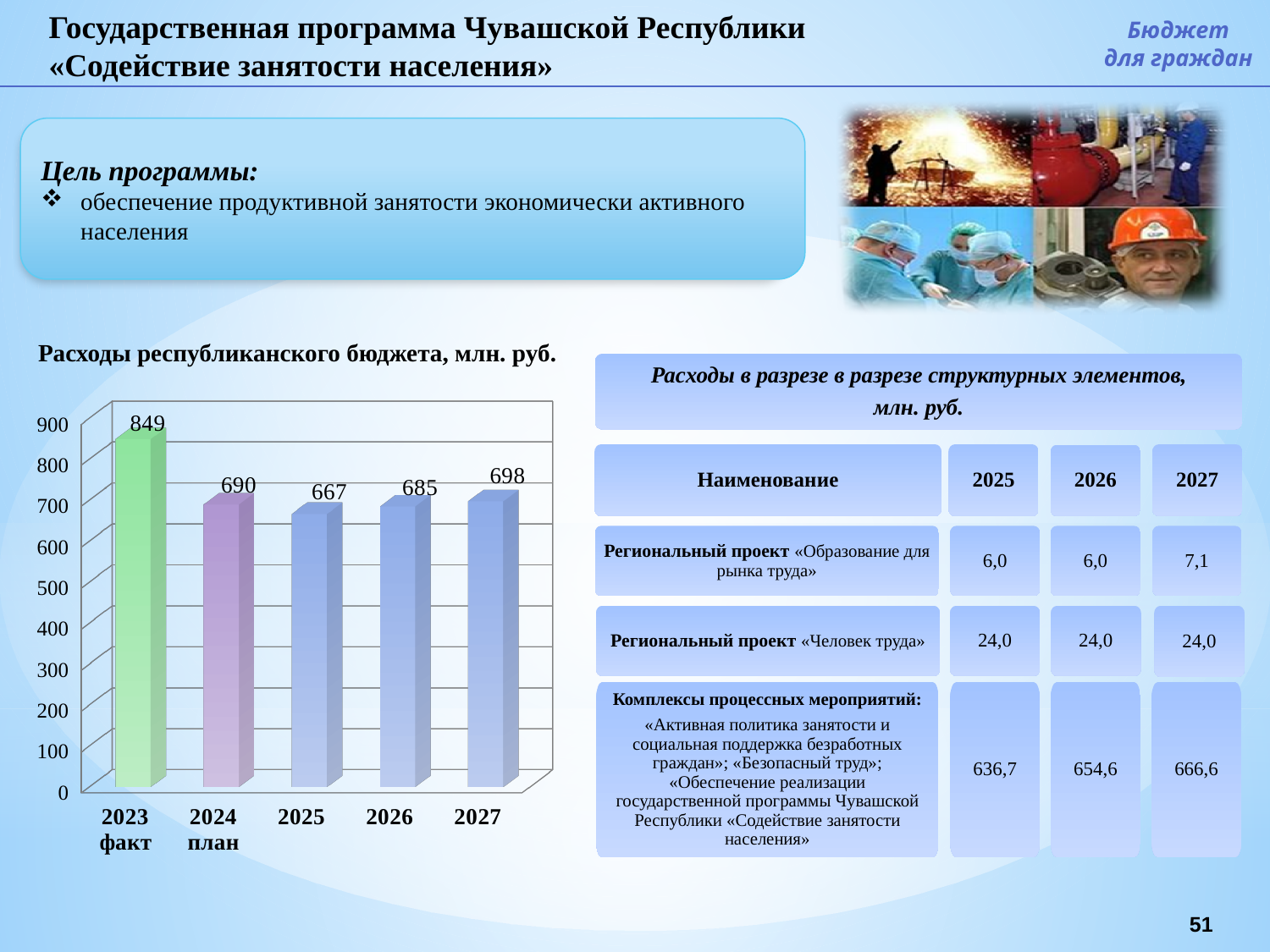
What is the difference between the values for 2027 and 2026 in the chart 'Расходы республиканского бюджета, млн. руб.'? 13 How many bars are shown in the chart 'Расходы республиканского бюджета, млн. руб.'? 5 Is the value for 2026 greater or less than 600 in the chart 'Расходы республиканского бюджета, млн. руб.'? greater What is the value for 2025 in the chart 'Расходы республиканского бюджета, млн. руб.'? 667 What is the value for 2027 in the chart 'Расходы республиканского бюджета, млн. руб.'? 698 What is the value for 2023 факт in the chart 'Расходы республиканского бюджета, млн. руб.'? 849 Which year has the lowest value in the chart 'Расходы республиканского бюджета, млн. руб.'? 2025 Do the values rise or fall from 2025 to 2027 in the chart 'Расходы республиканского бюджета, млн. руб.'? rise What is the difference between the values for 2023 факт and 2024 план in the chart 'Расходы республиканского бюджета, млн. руб.'? 159 What kind of chart is 'Расходы республиканского бюджета, млн. руб.'? bar chart Which is larger in the chart 'Расходы республиканского бюджета, млн. руб.': the value for 2024 план or the value for 2025? 2024 план Which year has the highest value in the chart 'Расходы республиканского бюджета, млн. руб.'? 2023 факт